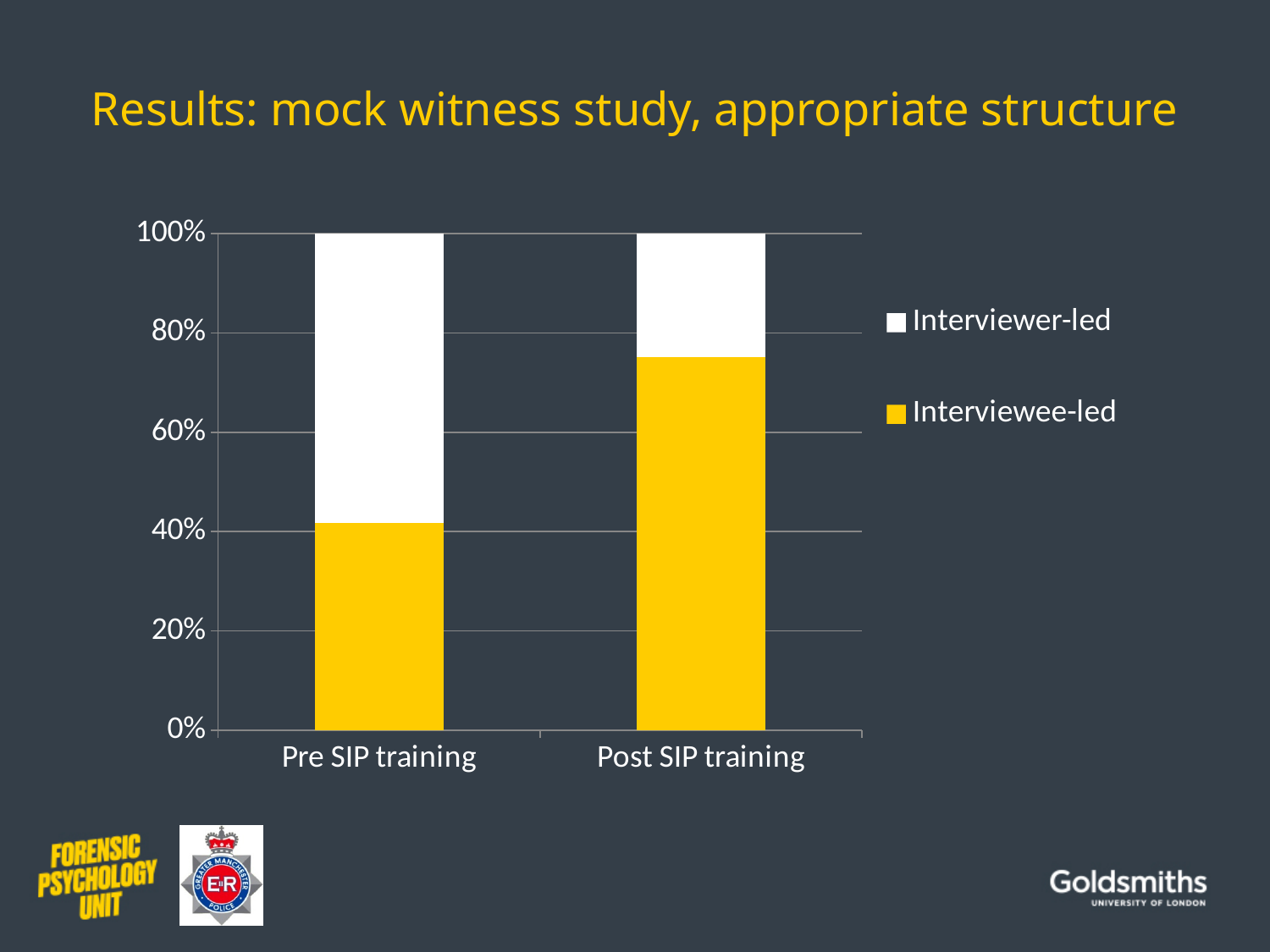
What is the title of the slide containing the chart? Results: mock witness study, appropriate structure Is the Interviewee-led value for Pre SIP training greater or less than 40%? greater Which category has the larger Interviewer-led share, Pre SIP training or Post SIP training? Pre SIP training Is the Interviewee-led value for Post SIP training greater or less than 60%? greater Which category has the larger Interviewee-led share, Pre SIP training or Post SIP training? Post SIP training How many series does the chart's legend list? 2 What kind of chart is shown on the slide? stacked bar chart Which series is shown in yellow in the chart? Interviewee-led Does the Interviewee-led share rise or fall from Pre SIP training to Post SIP training? rise Is the Interviewee-led value for Pre SIP training greater or less than 60%? less How many categories are shown on the x axis of the chart? 2